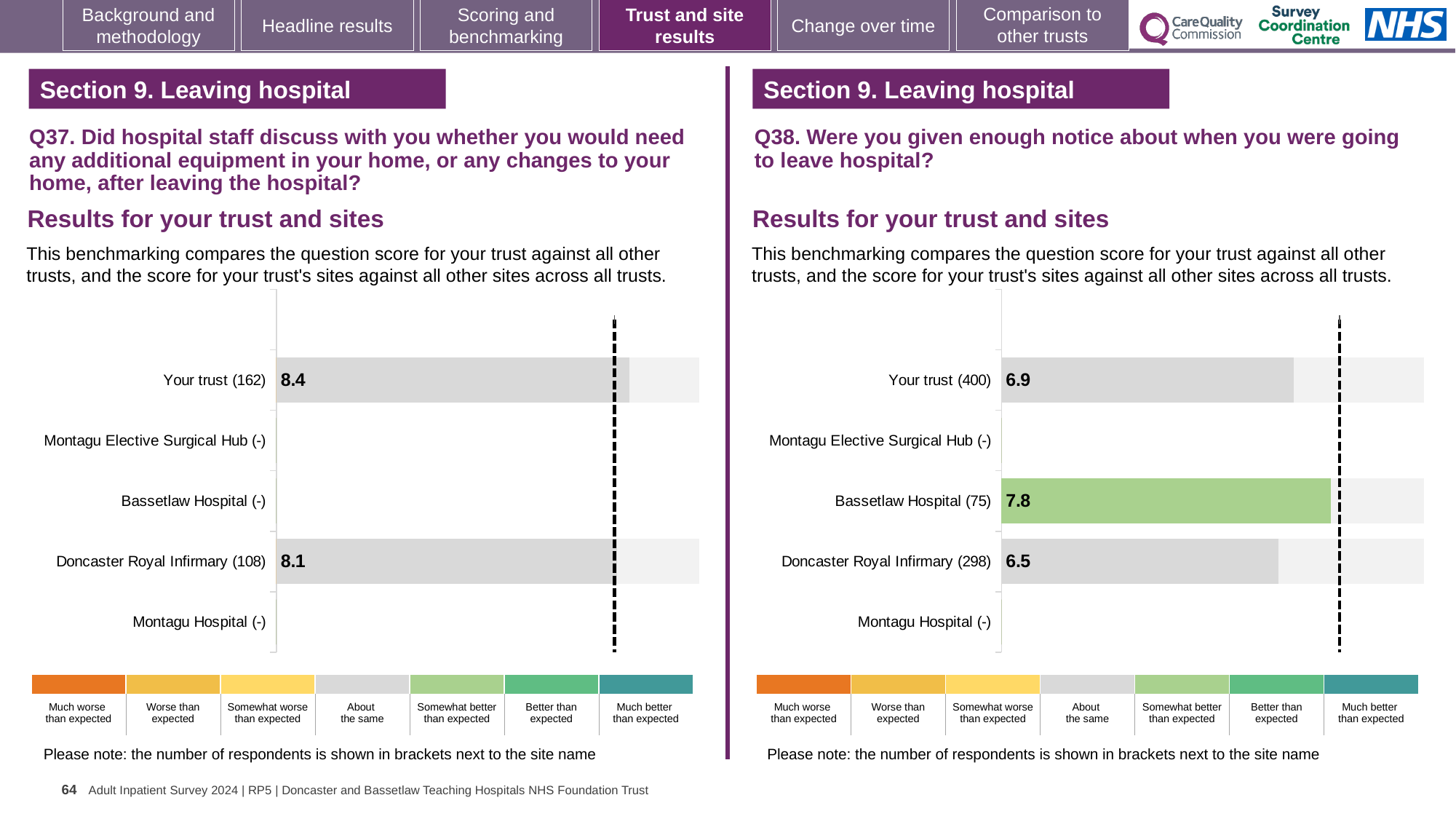
In the Q37 chart on the left, what is the score for Your trust (162)? 8.4 What kind of chart is used for the Q37 results on the left? Bar chart In the Q37 chart on the left, what is the difference between the scores for Your trust (162) and Doncaster Royal Infirmary (108)? 0.3 In the Q38 chart on the right, which site or trust row has the highest score? Bassetlaw Hospital (75) In the Q38 chart on the right, which site or trust row has the lowest score among those with a bar? Doncaster Royal Infirmary (298) In the Q38 chart on the right, what is the score for Doncaster Royal Infirmary (298)? 6.5 In the Q38 chart on the right, what is the score for Bassetlaw Hospital (75)? 7.8 How many site or trust rows are listed on the y axis of the Q38 chart on the right? 5 In the Q37 chart on the left, which has the larger score: Your trust (162) or Doncaster Royal Infirmary (108)? Your trust (162) In the Q37 chart on the left, what is the score for Doncaster Royal Infirmary (108)? 8.1 In the Q38 chart on the right, what is the difference between the scores for Bassetlaw Hospital (75) and Doncaster Royal Infirmary (298)? 1.3 In the Q38 chart on the right, what is the score for Your trust (400)? 6.9